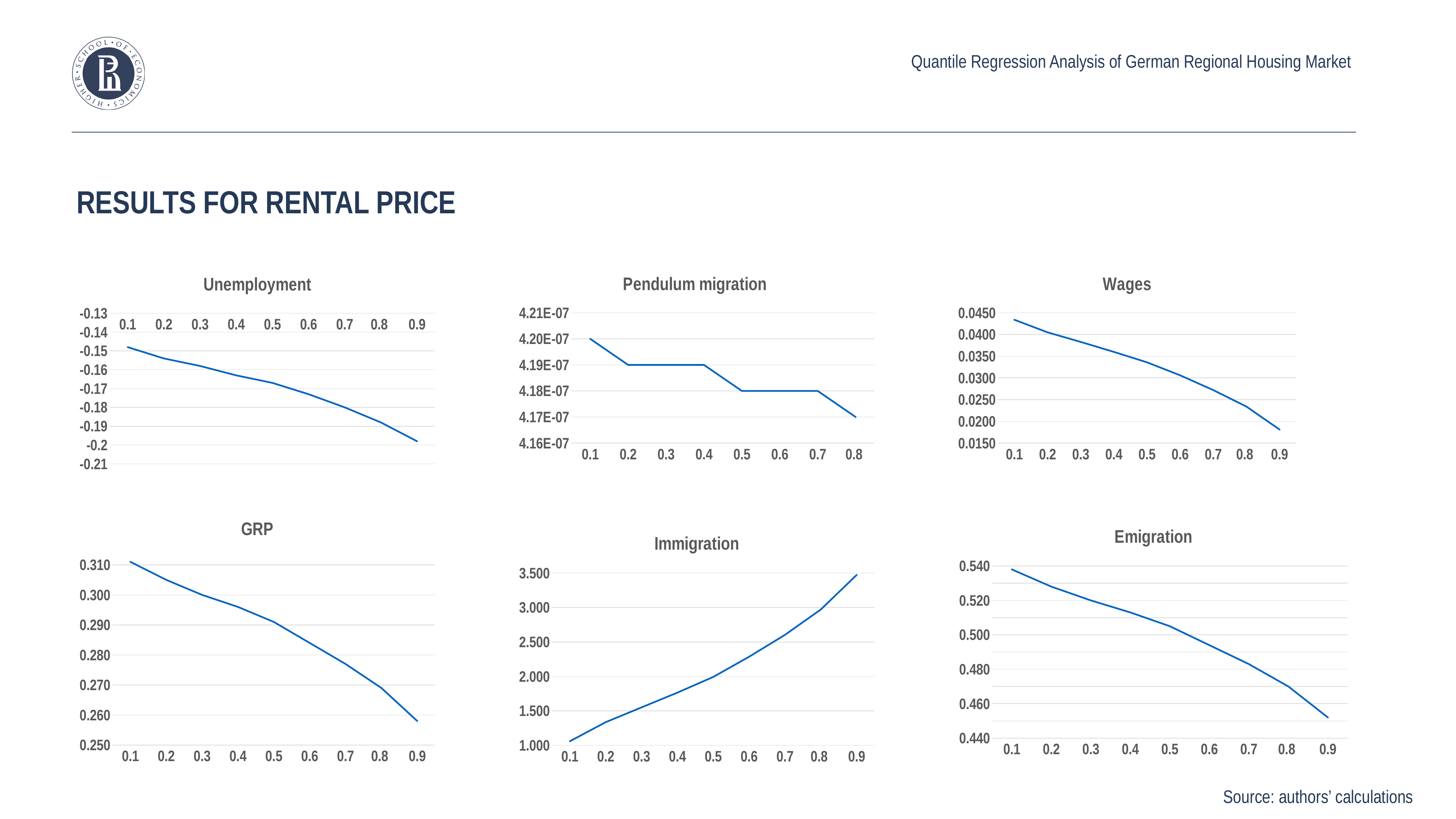
What type of chart is the Unemployment chart? line chart In the Wages chart, do the values rise or fall as the quantile increases from 0.1 to 0.9? fall In the Emigration chart, is the value at quantile 0.9 greater or less than 0.460? less In the GRP chart, is the value at quantile 0.1 greater or less than 0.300? greater In the Immigration chart, at which quantile is the value highest? 0.9 In the Wages chart, is the value at quantile 0.9 greater or less than 0.0200? less In the Pendulum migration chart, what is the value at quantile 0.8? 4.17E-07 In the Pendulum migration chart, what is the value at quantile 0.1? 4.20E-07 In the Immigration chart, do the values rise or fall as the quantile increases from 0.1 to 0.9? rise In the Pendulum migration chart, how many quantile points are plotted? 8 In the Pendulum migration chart, what is the value at quantile 0.6? 4.18E-07 In the Pendulum migration chart, what is the difference between the values at 0.1 and 0.8? 0.03E-07